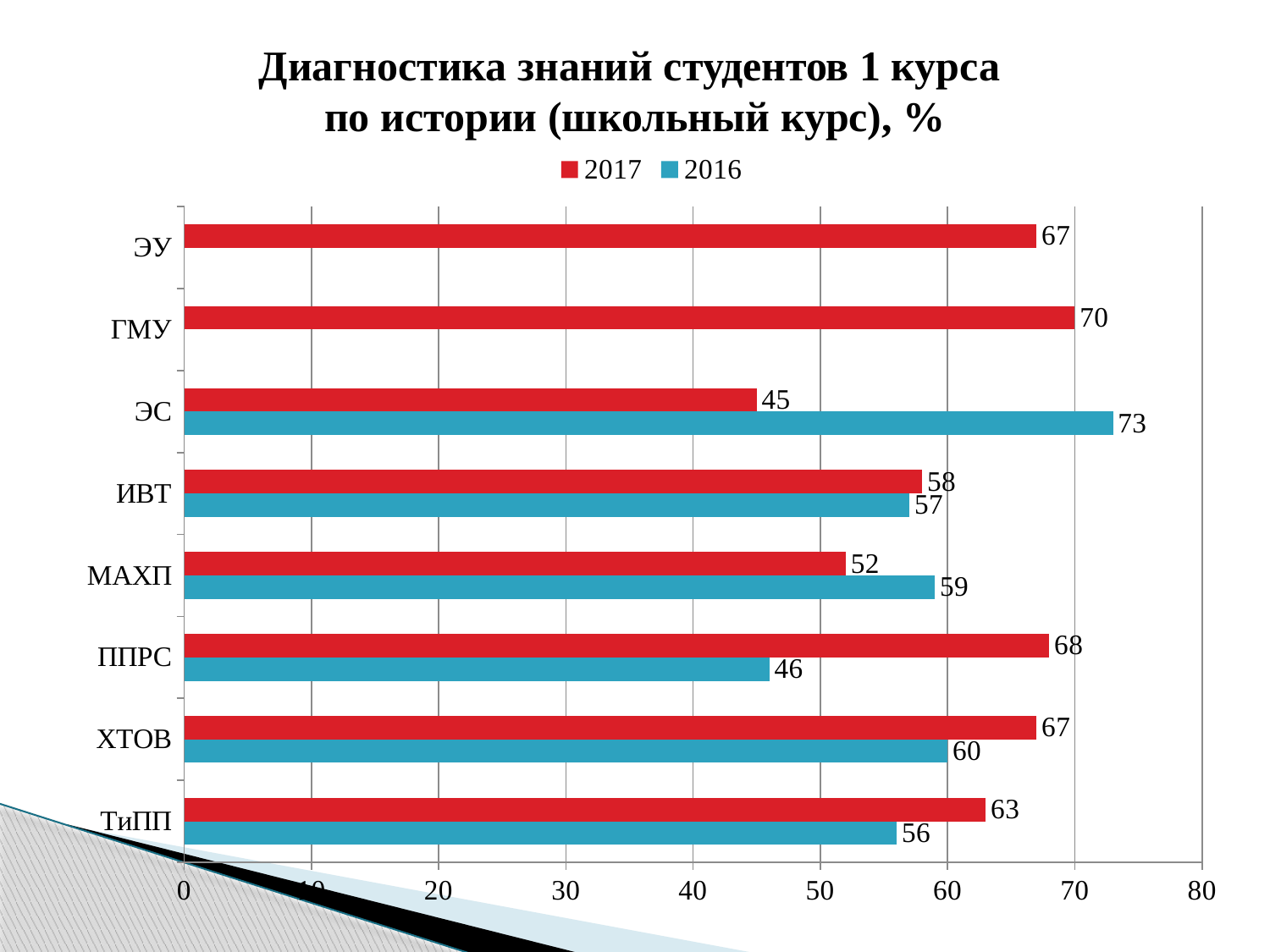
What is the 2016 value for ЭС? 73 Which category has the lowest 2016 value? ППРС What is the 2017 value for ГМУ? 70 How many categories are shown on the chart? 8 Which category has the lowest 2017 value? ЭС Which category has the highest 2017 value? ГМУ What kind of chart is shown on the slide? Bar chart What is the difference between the 2016 and 2017 values for ЭС? 28 Which colour represents the 2016 series? Blue Which is larger for МАХП, the 2017 value or the 2016 value? 2016 What is the 2016 value for ППРС? 46 How many series does the legend list? 2